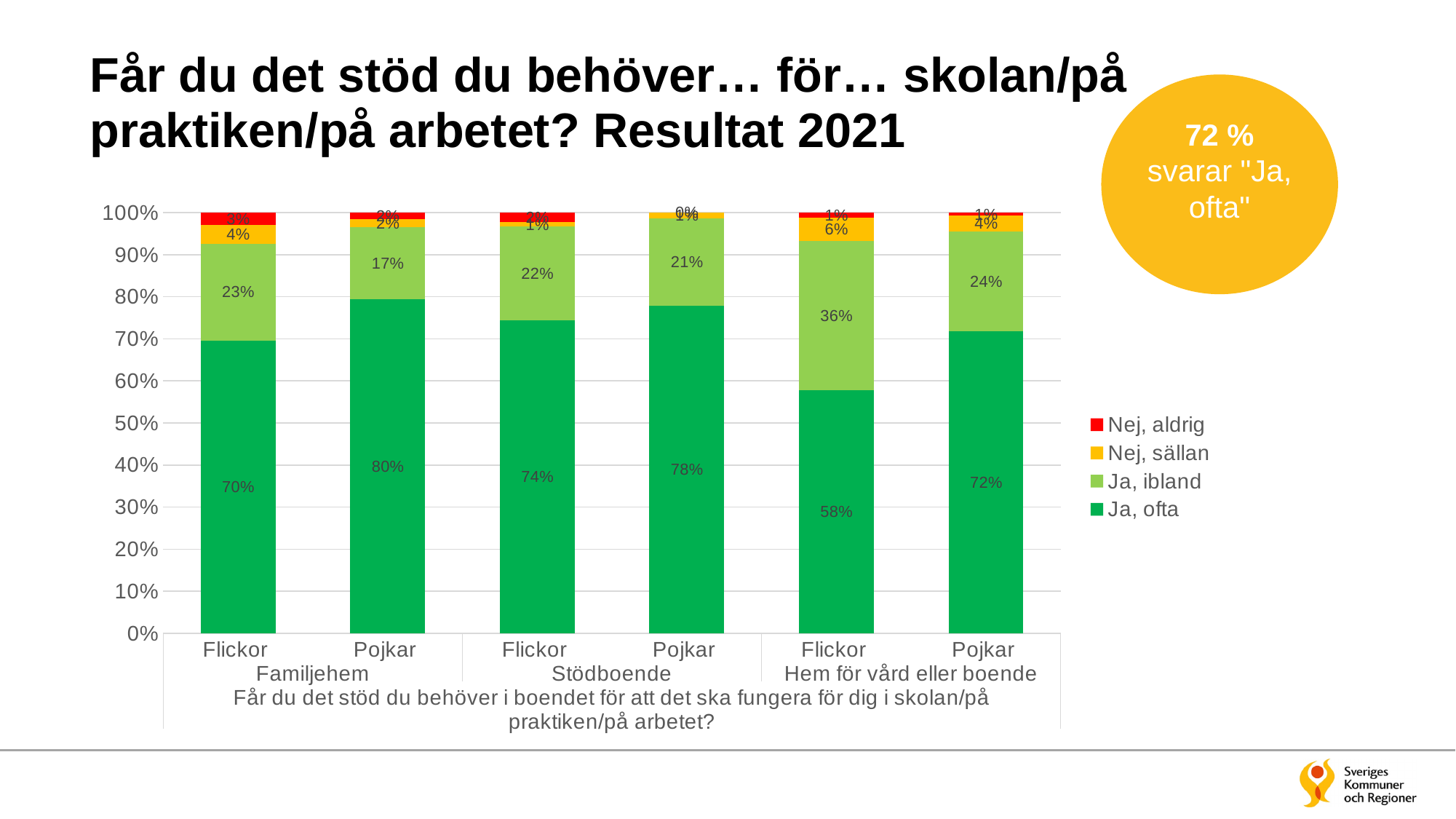
Is the "Ja, ofta" value for Flickor in Hem för vård eller boende greater or less than 60%? less How many series does the legend list? 4 How many bars are plotted in the chart? 6 Which bar has the highest "Ja, ofta" value? Pojkar, Familjehem What is the "Ja, ofta" value for Pojkar in Familjehem? 80% What is the "Ja, ibland" value for Flickor in Hem för vård eller boende? 36% Which is larger: the "Ja, ibland" value for Flickor in Familjehem or for Pojkar in Familjehem? Flickor in Familjehem What kind of chart is shown on the slide? Stacked bar chart What percentage does the yellow circle on the slide say answer "Ja, ofta"? 72 % What is the difference between the "Ja, ofta" values for Pojkar and Flickor in Stödboende? 4% What is the "Nej, sällan" value for Flickor in Familjehem? 4% Which bar has the lowest "Ja, ofta" value? Flickor, Hem för vård eller boende